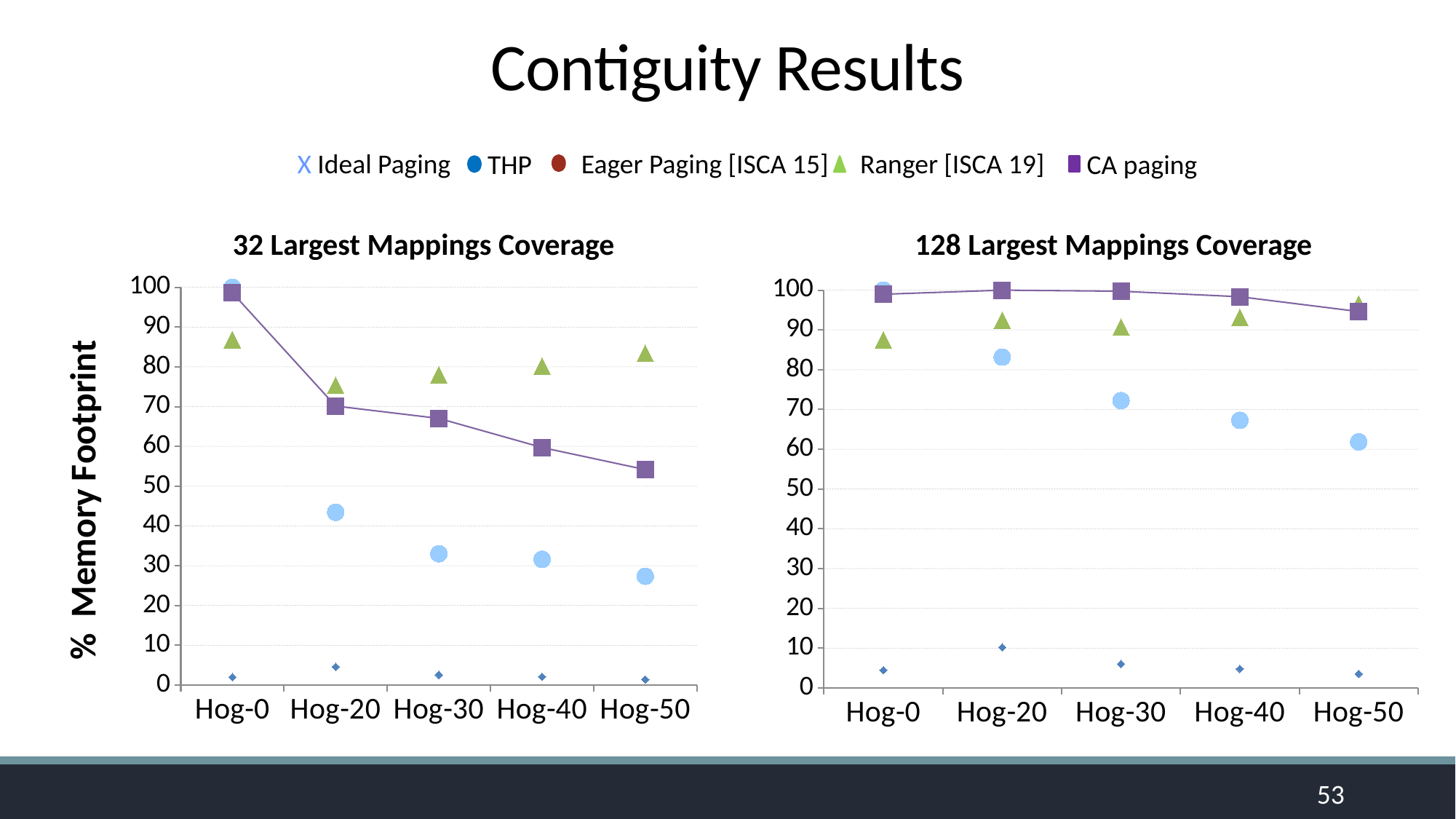
How many series does the legend list? 5 In the 32 Largest Mappings Coverage chart, at Hog-30, which is larger: Ranger [ISCA 19] or CA paging? Ranger [ISCA 19] In the 32 Largest Mappings Coverage chart, which category has the lowest THP value? Hog-50 In the 32 Largest Mappings Coverage chart, is the THP value for Hog-20 greater or less than 50? less In the 32 Largest Mappings Coverage chart, do the CA paging values rise or fall from Hog-0 to Hog-50? fall In the 32 Largest Mappings Coverage chart, is the CA paging value for Hog-50 greater or less than 50? greater What is the y-axis label shared by the two charts? % Memory Footprint In the 128 Largest Mappings Coverage chart, do the THP values rise or fall from Hog-0 to Hog-50? fall In the 32 Largest Mappings Coverage chart, how many categories are on the x axis? 5 In the 128 Largest Mappings Coverage chart, is the THP value for Hog-50 greater or less than 70? less In the 128 Largest Mappings Coverage chart, at Hog-20, which is larger: CA paging or THP? CA paging